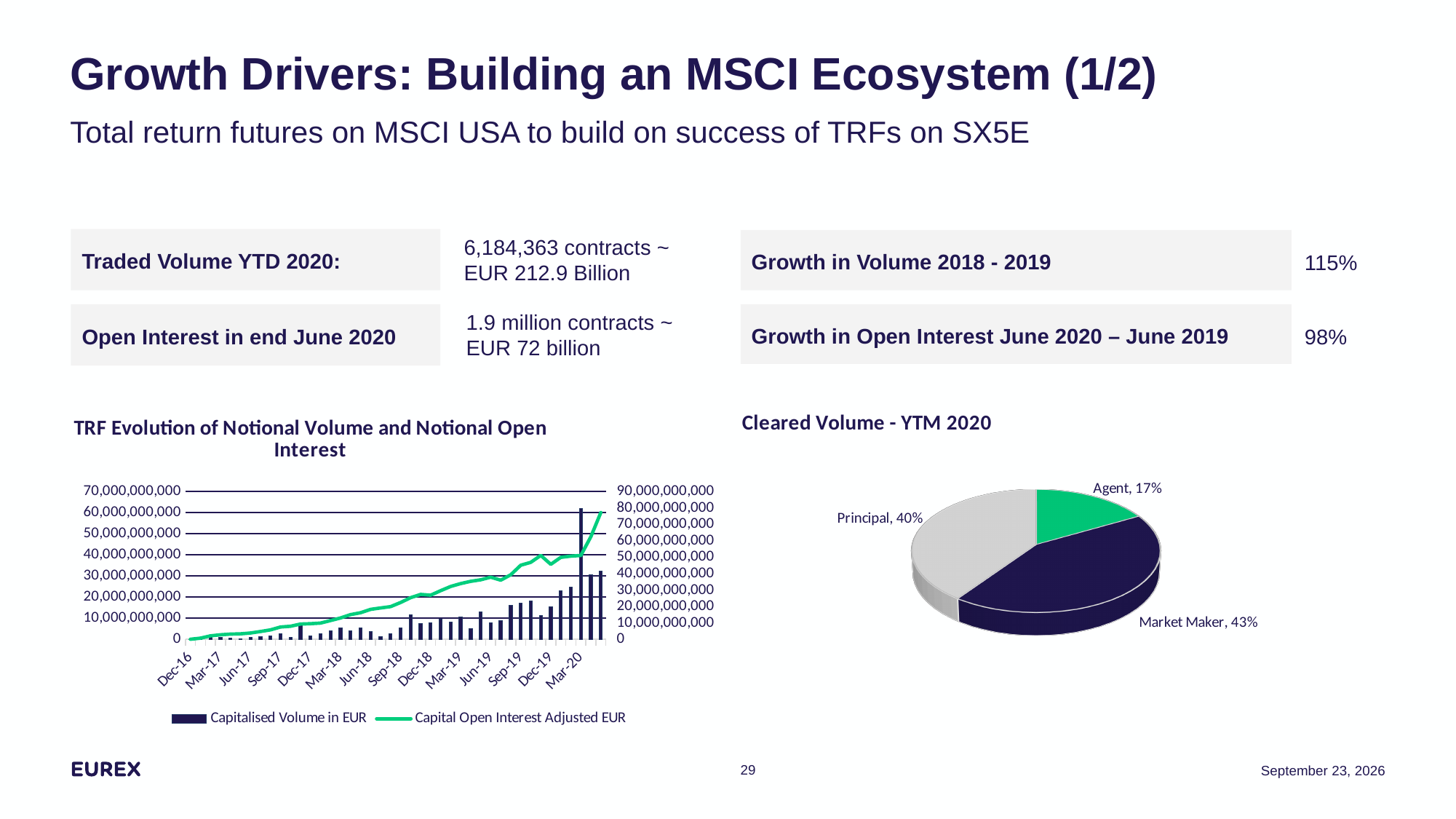
How many series does the legend of the 'TRF Evolution of Notional Volume and Notional Open Interest' chart list? 2 In the 'Cleared Volume - YTM 2020' pie chart, what share does Agent have? 17% In the 'TRF Evolution of Notional Volume and Notional Open Interest' chart, is the tallest Capitalised Volume in EUR bar greater or less than 50,000,000,000 on the left axis? greater In the 'Cleared Volume - YTM 2020' pie chart, what share does Market Maker have? 43% In the 'TRF Evolution of Notional Volume and Notional Open Interest' chart, does the Capital Open Interest Adjusted EUR line generally rise or fall from Dec-16 to Mar-20? Rise In the 'Cleared Volume - YTM 2020' pie chart, which category has the smallest share? Agent In the 'Cleared Volume - YTM 2020' pie chart, which category has the largest share? Market Maker What kind of chart is 'Cleared Volume - YTM 2020'? Pie chart In the 'Cleared Volume - YTM 2020' pie chart, what is the difference in percentage points between Principal and Agent? 23 In the 'Cleared Volume - YTM 2020' pie chart, which is larger, Principal or Market Maker? Market Maker How many slices does the 'Cleared Volume - YTM 2020' pie chart have? 3 In the 'TRF Evolution of Notional Volume and Notional Open Interest' chart, which series is shown as a green line? Capital Open Interest Adjusted EUR